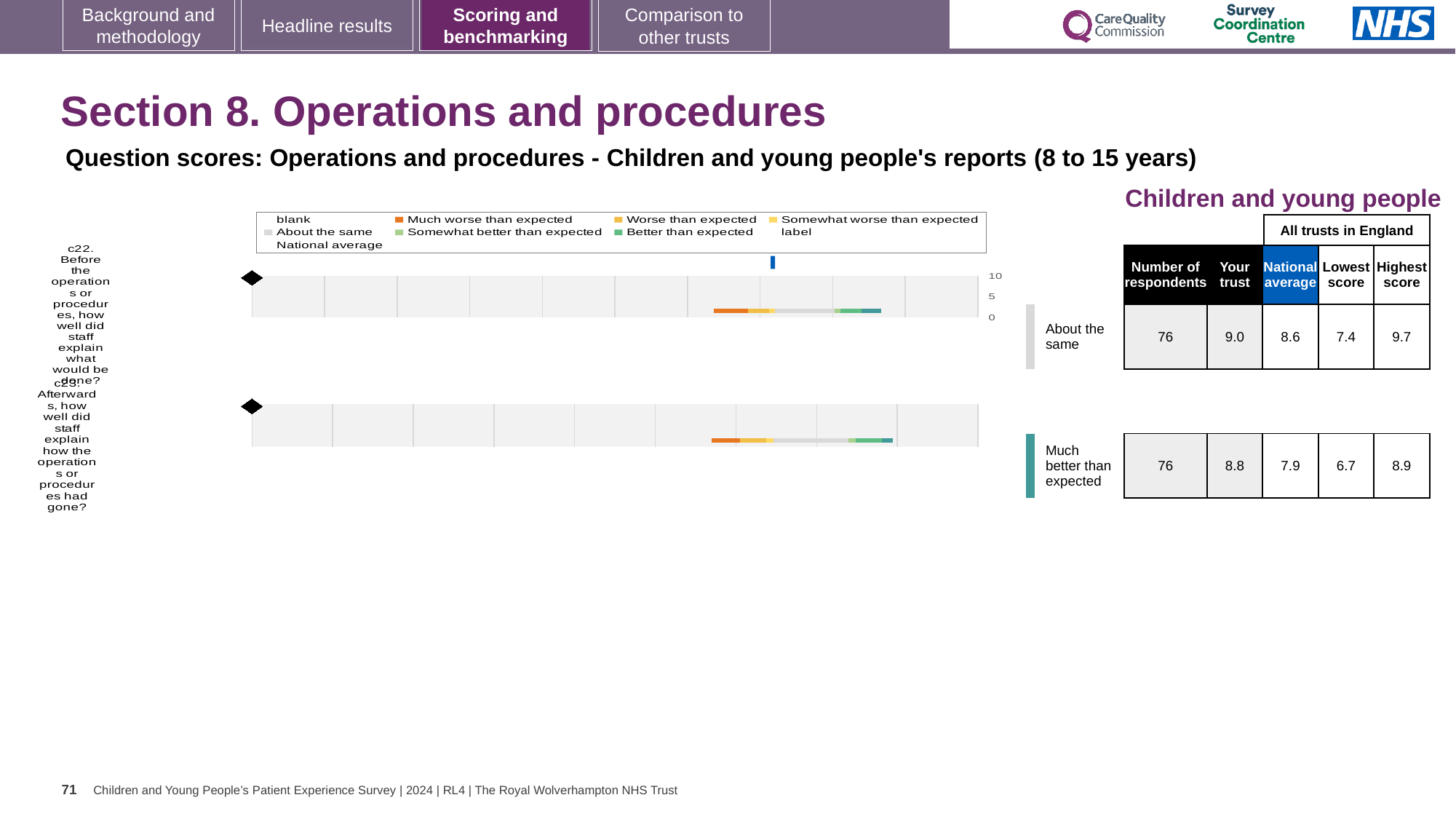
What is the highest score among all trusts in England for question c23? 8.9 What is the difference between the trust's score and the national average for question c23? 0.9 For question c22, is the trust's score higher or lower than the national average? higher What kind of chart is used to show the question scores for c22 and c23? bar chart What is the national average score for question c23? 7.9 What is the 'Your trust' score for question c22? 9.0 Which colour does the legend use for 'Much worse than expected'? orange How many respondents answered question c22? 76 How many survey questions are plotted in the chart? 2 What benchmark category is shown for question c23 (Afterwards, how well did staff explain how the operations or procedures had gone?)? Much better than expected What is the highest value shown on the chart's score axis? 10 What benchmark category is shown for question c22 (Before the operations or procedures, how well did staff explain what would be done?)? About the same